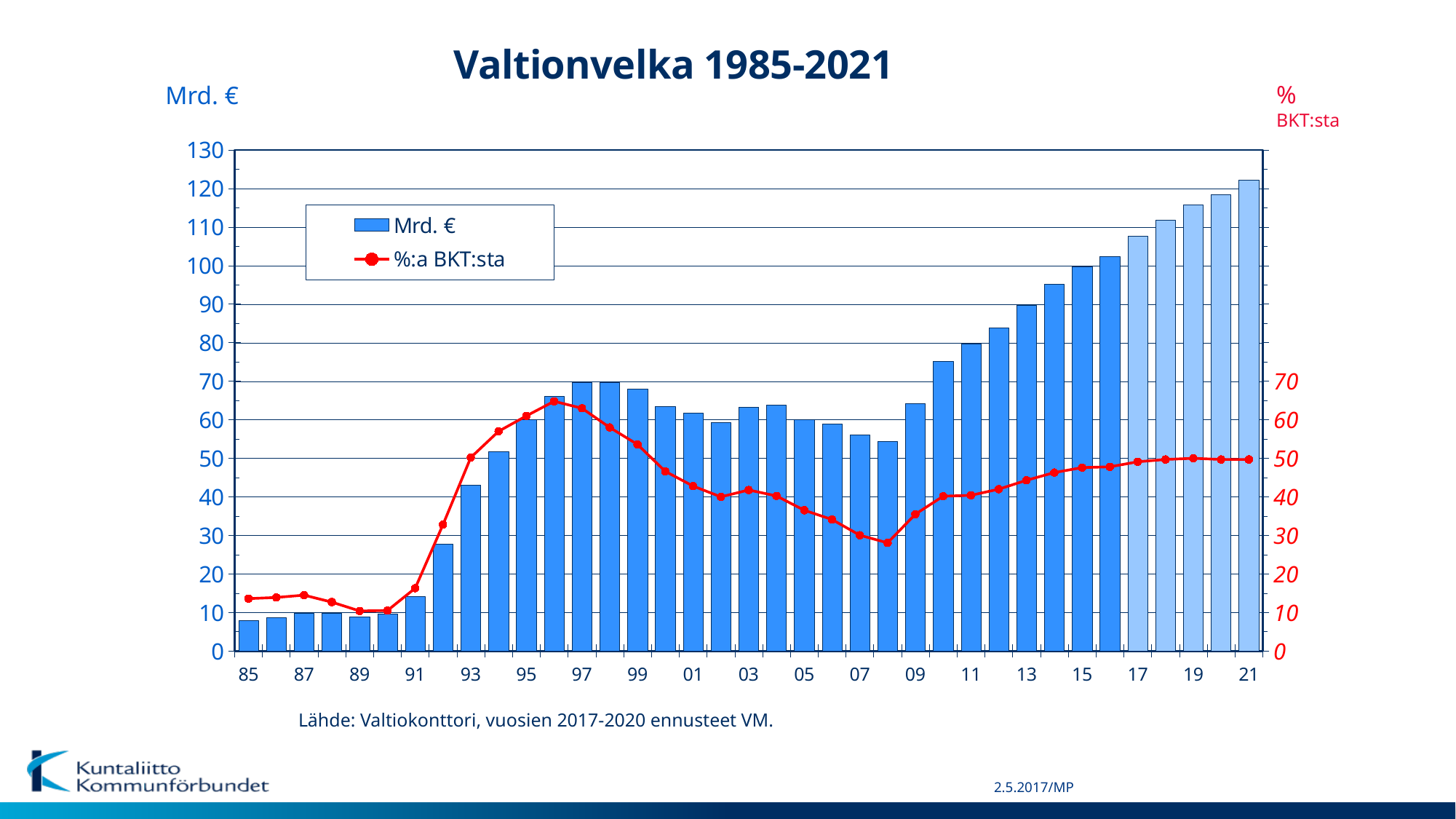
Is the Mrd. € value for 85 greater or less than 10? less Is the Mrd. € value for 21 greater or less than 110? greater Is the %:a BKT:sta value for 07 greater or less than 40? less What is the title of the chart? Valtionvelka 1985-2021 Which year has the larger Mrd. € bar, 10 or 16? 16 How many series does the legend list? 2 In which year does the %:a BKT:sta line reach its highest point? 96 Do the Mrd. € bars rise or fall from 09 to 21? rise Which series is drawn as a red line with markers? %:a BKT:sta Which year has the highest Mrd. € bar? 21 What kind of chart is shown on the slide? A combined bar and line chart